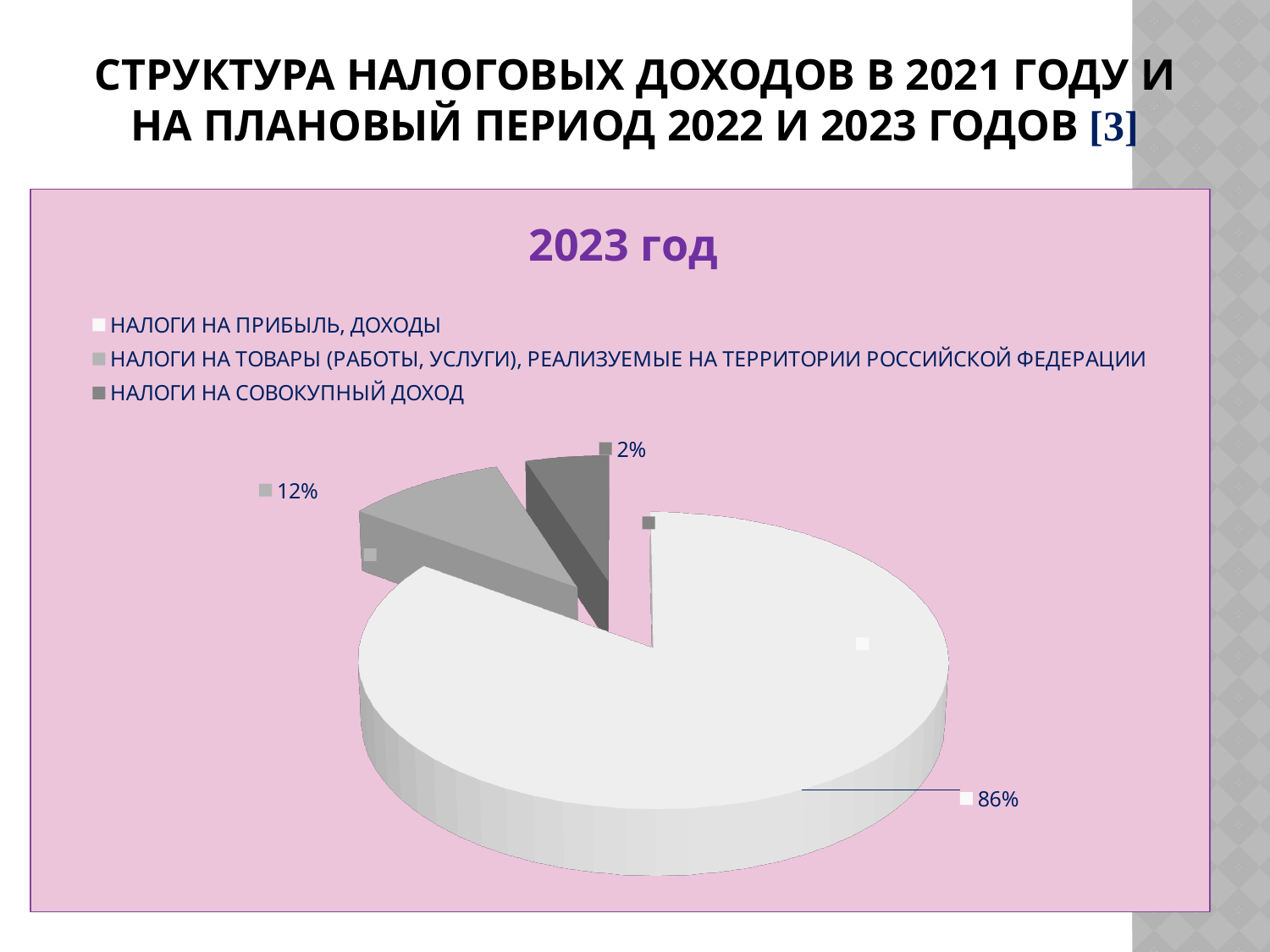
Which category has the largest slice of the pie? НАЛОГИ НА ПРИБЫЛЬ, ДОХОДЫ What share of the pie is НАЛОГИ НА ПРИБЫЛЬ, ДОХОДЫ? 86% What share of the pie is НАЛОГИ НА ТОВАРЫ (РАБОТЫ, УСЛУГИ), РЕАЛИЗУЕМЫЕ НА ТЕРРИТОРИИ РОССИЙСКОЙ ФЕДЕРАЦИИ? 12% How many slices does the pie chart have? 3 What is the chart's title? 2023 год Which legend entry is shown in the darkest gray colour? НАЛОГИ НА СОВОКУПНЫЙ ДОХОД What kind of chart is shown on the slide? Pie chart Which category has the smallest slice of the pie? НАЛОГИ НА СОВОКУПНЫЙ ДОХОД Which is larger: the share for НАЛОГИ НА ТОВАРЫ (РАБОТЫ, УСЛУГИ), РЕАЛИЗУЕМЫЕ НА ТЕРРИТОРИИ РОССИЙСКОЙ ФЕДЕРАЦИИ or for НАЛОГИ НА СОВОКУПНЫЙ ДОХОД? НАЛОГИ НА ТОВАРЫ (РАБОТЫ, УСЛУГИ), РЕАЛИЗУЕМЫЕ НА ТЕРРИТОРИИ РОССИЙСКОЙ ФЕДЕРАЦИИ What is the difference in percentage points between НАЛОГИ НА ПРИБЫЛЬ, ДОХОДЫ and НАЛОГИ НА ТОВАРЫ (РАБОТЫ, УСЛУГИ), РЕАЛИЗУЕМЫЕ НА ТЕРРИТОРИИ РОССИЙСКОЙ ФЕДЕРАЦИИ? 74% What share of the pie is НАЛОГИ НА СОВОКУПНЫЙ ДОХОД? 2% How many entries does the legend list? 3